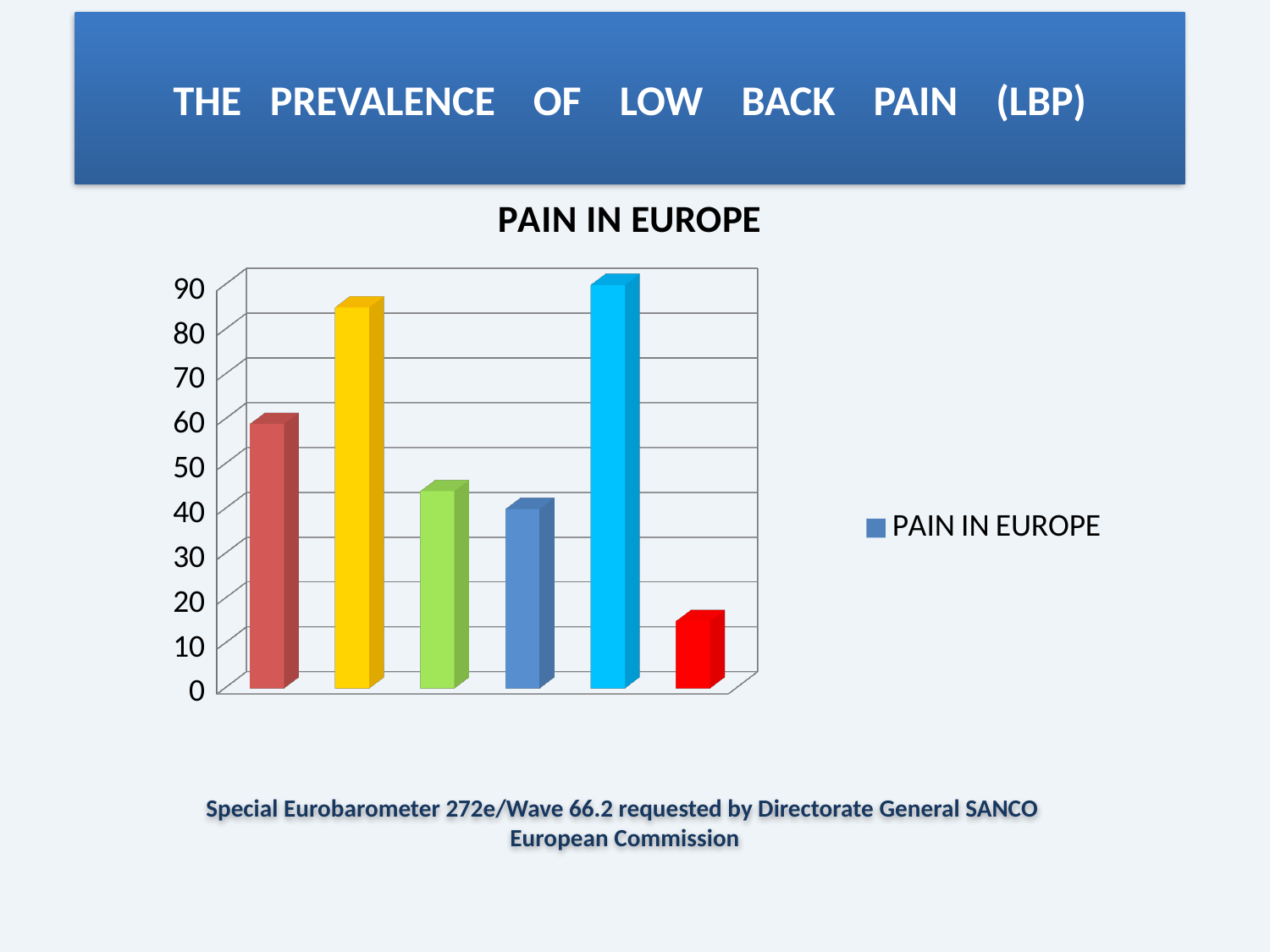
Which is larger, the value of the first (dark red) bar or the third (green) bar? the first (dark red) bar Is the value of the second (yellow) bar greater or less than 80? greater Is the value of the first (leftmost, dark red) bar greater or less than 50? greater What is the title of the chart? PAIN IN EUROPE Which bar is the lowest in the chart? the sixth (rightmost, red) bar Which bar is the highest in the chart? the fifth (light blue) bar How many series does the legend list? 1 How many bars are plotted in the chart? 6 Is the value of the sixth (rightmost, red) bar greater or less than 20? less What is the name of the series shown in the legend? PAIN IN EUROPE What kind of chart is shown on the slide? bar chart